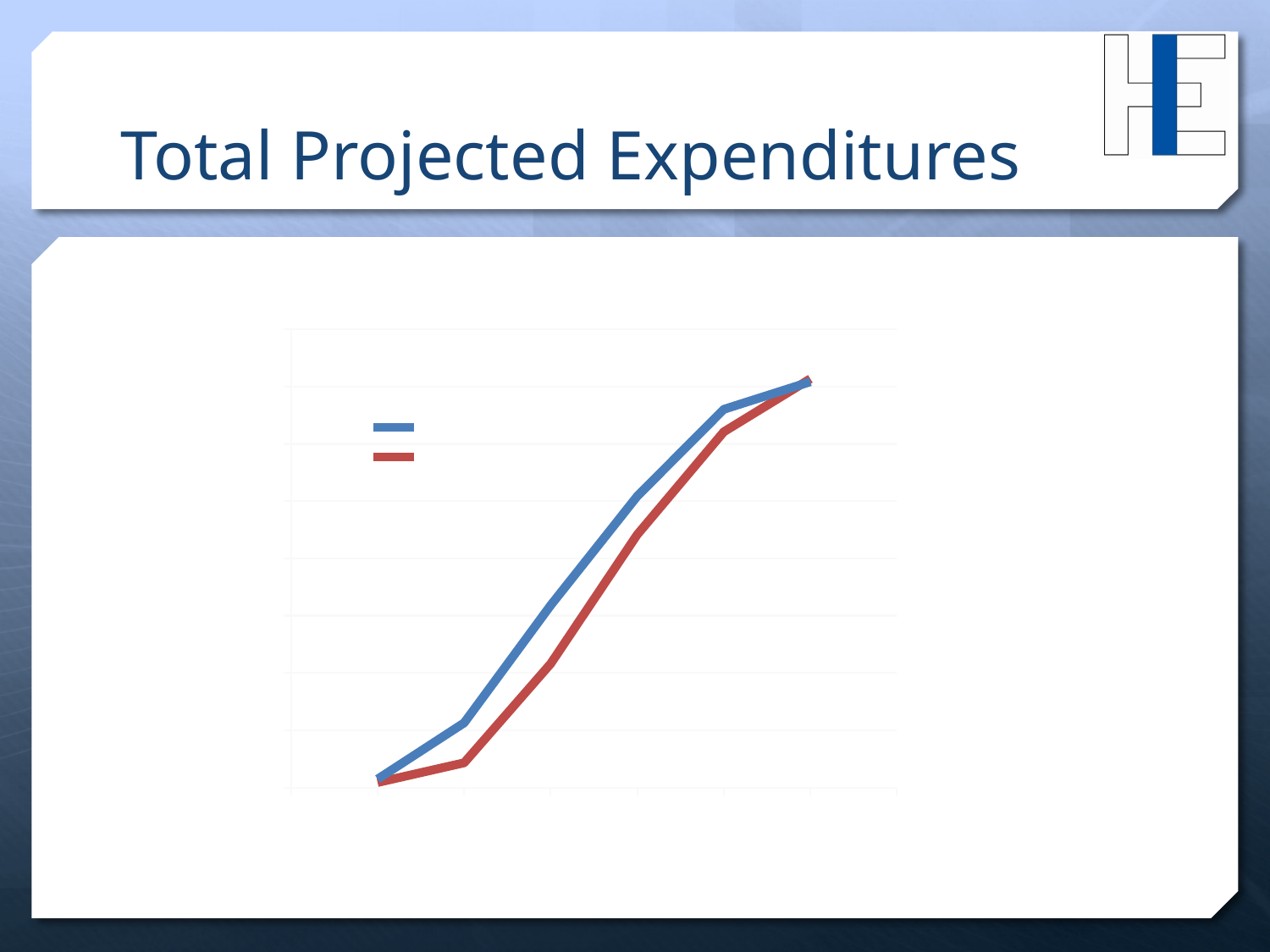
What is the title shown above the chart on the slide? Total Projected Expenditures Do the values in the chart rise or fall from left to right along the x axis? rise How many series does the chart's legend list? 2 At the fourth point from the left, which line is higher, the blue line or the red line? blue line At the second point from the left, which line is higher, the blue line or the red line? blue line How many data points does each line in the chart have? 6 What two colours are used for the lines in the chart? blue and red What kind of chart is shown on the slide? line chart